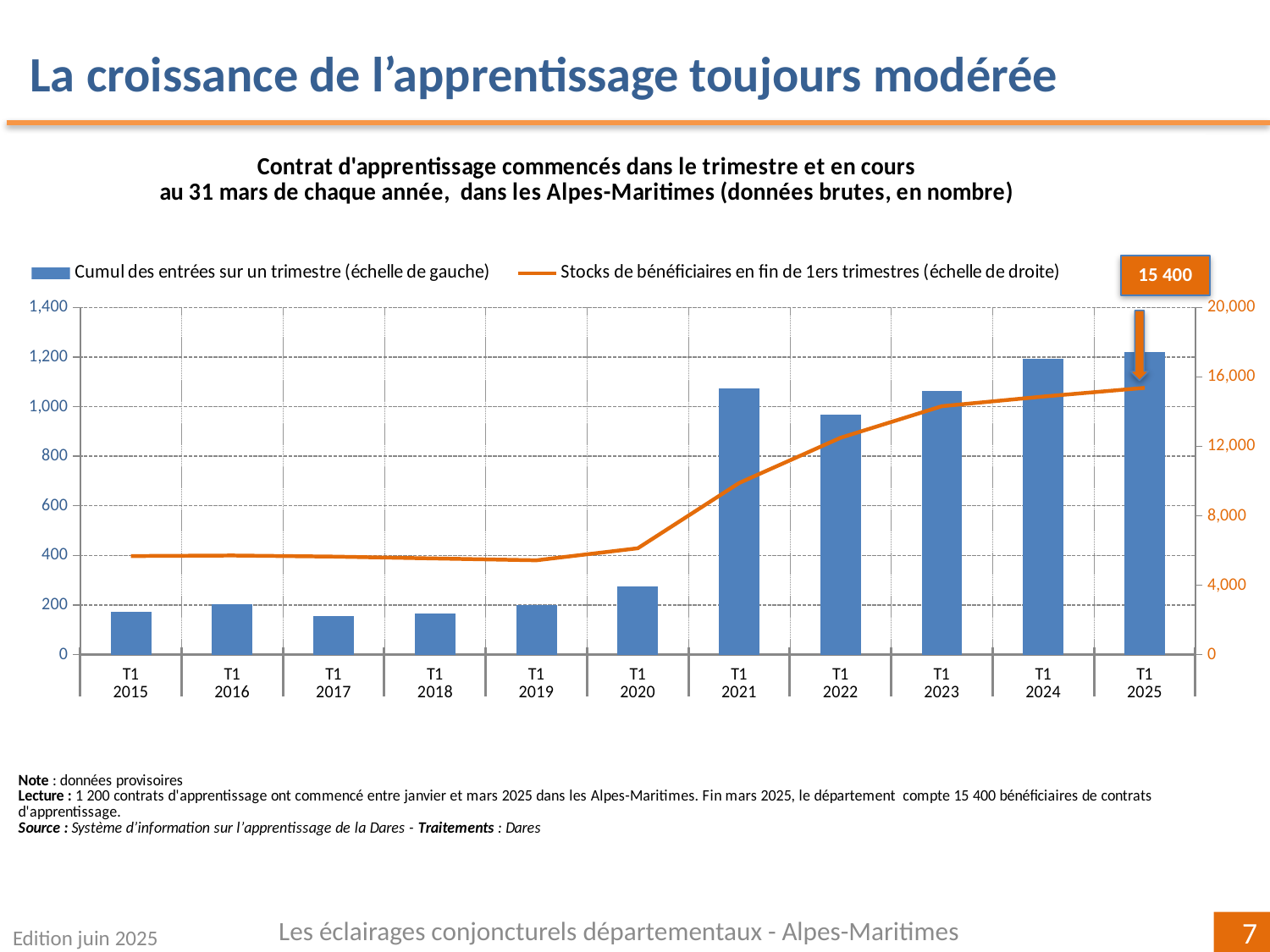
Which has the higher bar value, T1 2020 or T1 2021? T1 2021 How many series does the legend list? 2 Which has the higher bar value, T1 2021 or T1 2022? T1 2021 Is the bar value for T1 2020 greater or less than 400? less How many quarters (categories) are shown on the x axis? 11 Is the bar value for T1 2024 greater or less than 1,000? greater Is the bar value for T1 2021 greater or less than 1,000? greater Does the line for stocks of beneficiaries rise or fall between T1 2020 and T1 2025? rise Which series is plotted on the right-hand axis (échelle de droite)? Stocks de bénéficiaires en fin de 1ers trimestres What value is shown in the callout for the stock of beneficiaries at T1 2025? 15 400 What kind of chart is this? Combined bar and line chart